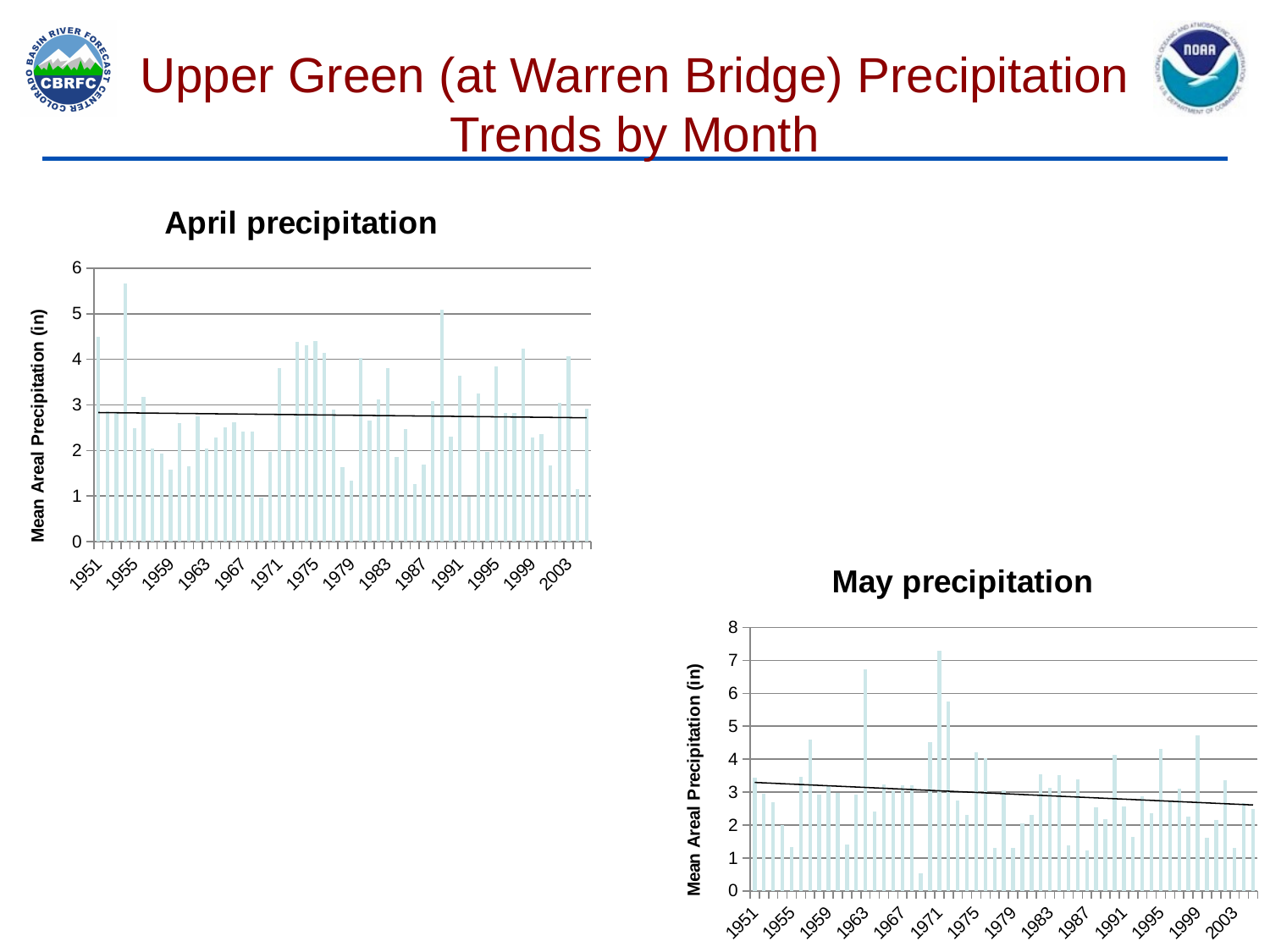
What kind of chart is the April precipitation chart? bar chart In the April precipitation chart, is the value for 1951 greater or less than 4? greater What kind of chart is the May precipitation chart? bar chart What is the y-axis label on the May precipitation chart? Mean Areal Precipitation (in) In the April precipitation chart, does the fitted trend line rise or fall from 1951 to 2003? fall In the May precipitation chart, is the value for 1951 greater or less than 2? greater What is the highest tick value on the y-axis of the May precipitation chart? 8 In the April precipitation chart, is the value for 1951 greater or less than 3? greater In the May precipitation chart, does the fitted trend line rise or fall from 1951 to 2003? fall